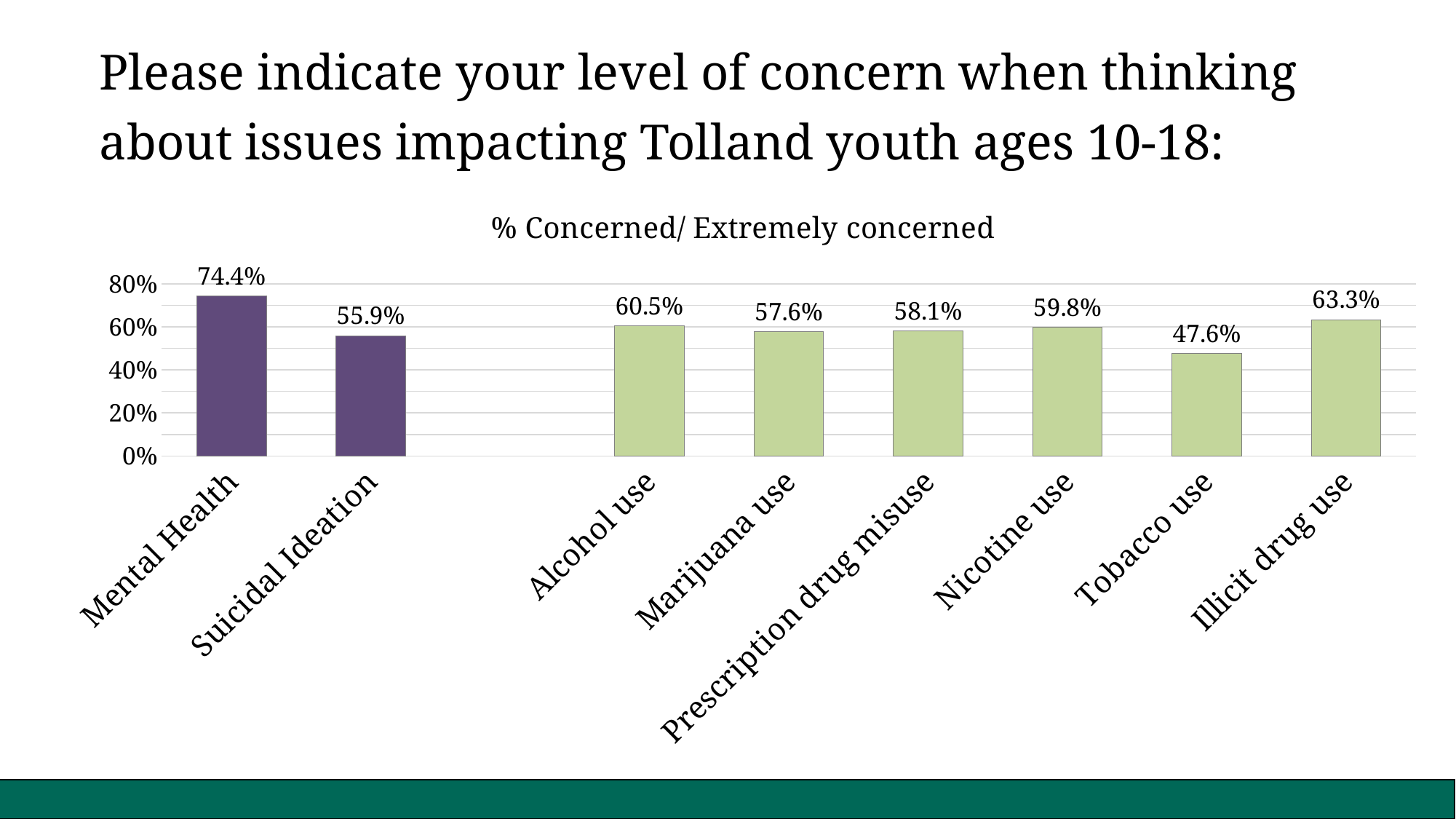
Which category has the highest value? Mental Health What is the title of the chart? % Concerned/ Extremely concerned What is the value for Tobacco use? 47.6% What is the value for Mental Health? 74.4% What kind of chart is shown on the slide? Bar chart What is the difference between the values for Mental Health and Suicidal Ideation? 18.5% Is the value for Nicotine use greater or less than 40%? greater What colour are the bars for Mental Health and Suicidal Ideation? Purple How many categories are shown in the chart? 8 Which category has the lowest value? Tobacco use Which is larger, the value for Illicit drug use or the value for Alcohol use? Illicit drug use What is the value for Prescription drug misuse? 58.1%